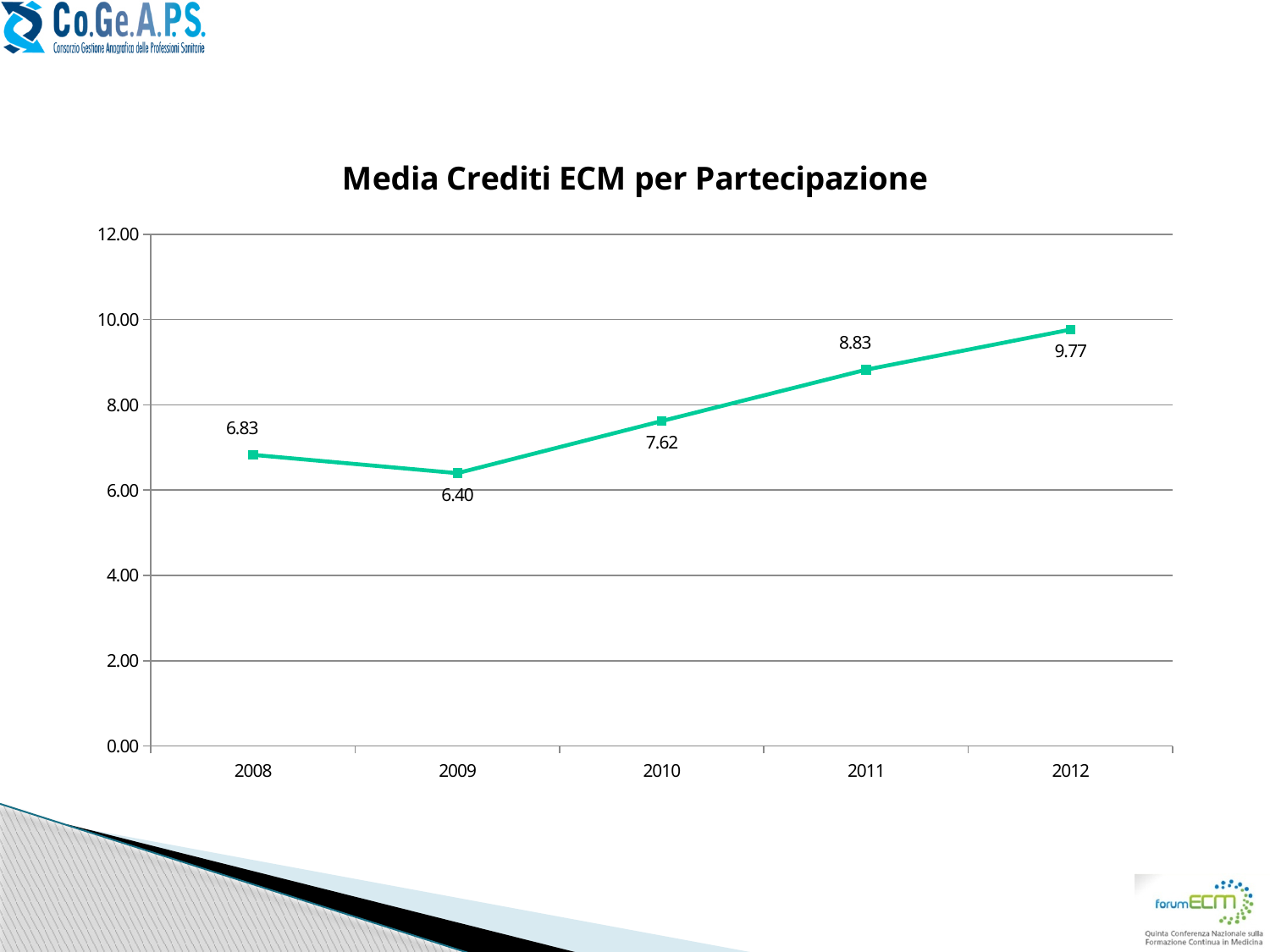
What is the difference between the values for 2011 and 2010? 1.21 What is the value for 2010? 7.62 What kind of chart is shown on the slide? line chart Which year has the lowest value? 2009 Is the value for 2011 greater or less than 8.00? greater What is the title of the chart? Media Crediti ECM per Partecipazione What is the value for 2008? 6.83 Which is larger, the value for 2009 or the value for 2011? 2011 Which year has the highest value? 2012 How many years are plotted on the chart? 5 What is the difference between the values for 2012 and 2008? 2.94 What is the value for 2012? 9.77